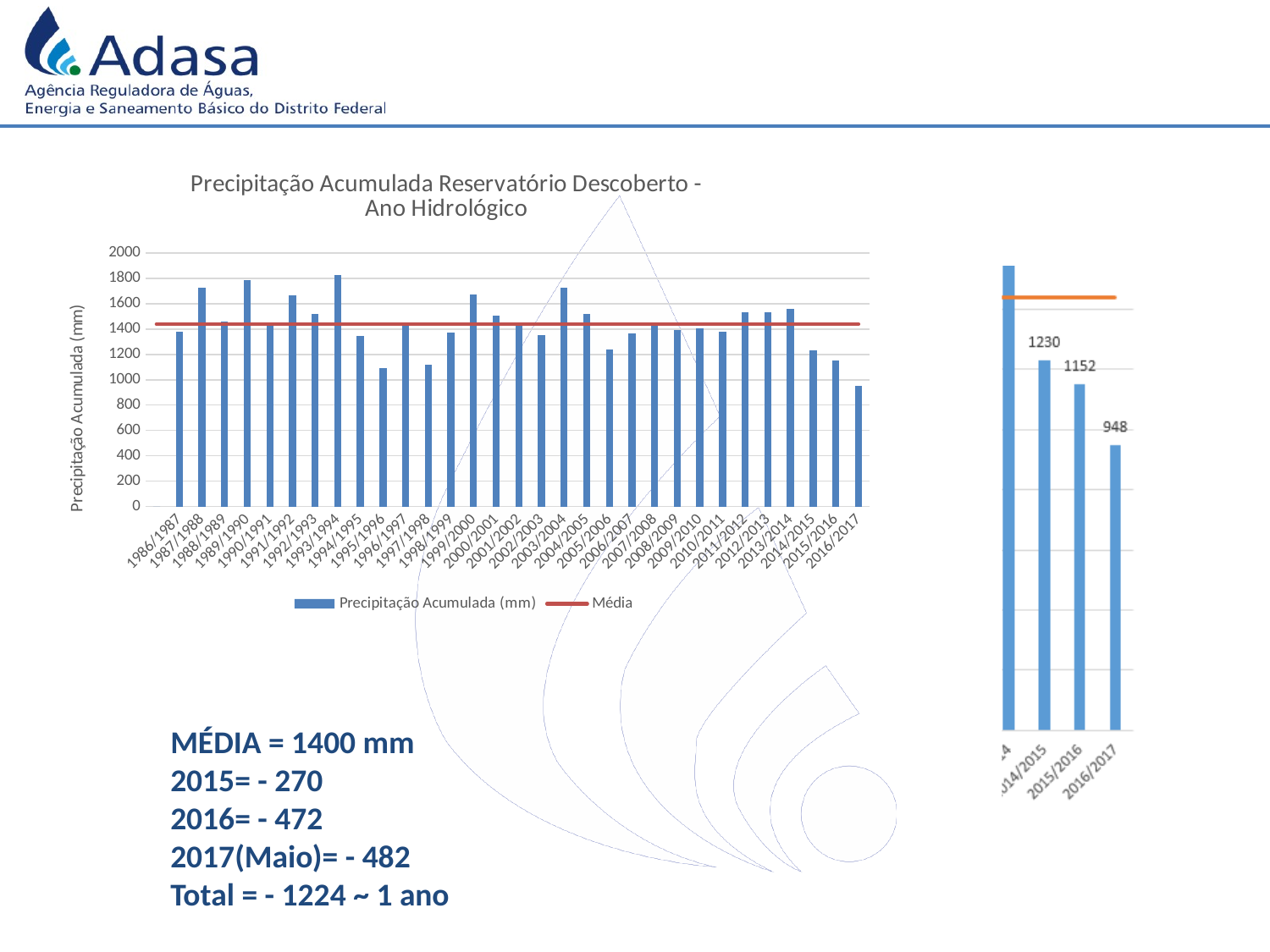
In the chart on the right side of the slide, what is the difference between the values for 2014/2015 and 2016/2017? 282 In the 'Precipitação Acumulada Reservatório Descoberto - Ano Hidrológico' chart, what are the two legend entries? Precipitação Acumulada (mm) and Média In the 'Precipitação Acumulada Reservatório Descoberto - Ano Hidrológico' chart, do the values rise or fall from 2013/2014 to 2016/2017? fall In the 'Precipitação Acumulada Reservatório Descoberto - Ano Hidrológico' chart, is the value for 1987/1988 greater or less than 1600? greater How many hydrological years are plotted on the x axis of the 'Precipitação Acumulada Reservatório Descoberto - Ano Hidrológico' chart? 31 What type of chart is the 'Precipitação Acumulada Reservatório Descoberto - Ano Hidrológico' chart? Combination bar and line chart (bars for precipitation with a line for the average) In the chart on the right side of the slide, what is the value for 2016/2017? 948 In the 'Precipitação Acumulada Reservatório Descoberto - Ano Hidrológico' chart, which is larger, the value for 1993/1994 or the value for 1996/1997? 1993/1994 In the 'Precipitação Acumulada Reservatório Descoberto - Ano Hidrológico' chart, is the value for 1995/1996 greater or less than 1200? less In the chart on the right side of the slide, what is the value for 2015/2016? 1152 How many series does the legend of the 'Precipitação Acumulada Reservatório Descoberto - Ano Hidrológico' chart list? 2 In the 'Precipitação Acumulada Reservatório Descoberto - Ano Hidrológico' chart, which hydrological year has the lowest accumulated precipitation? 2016/2017